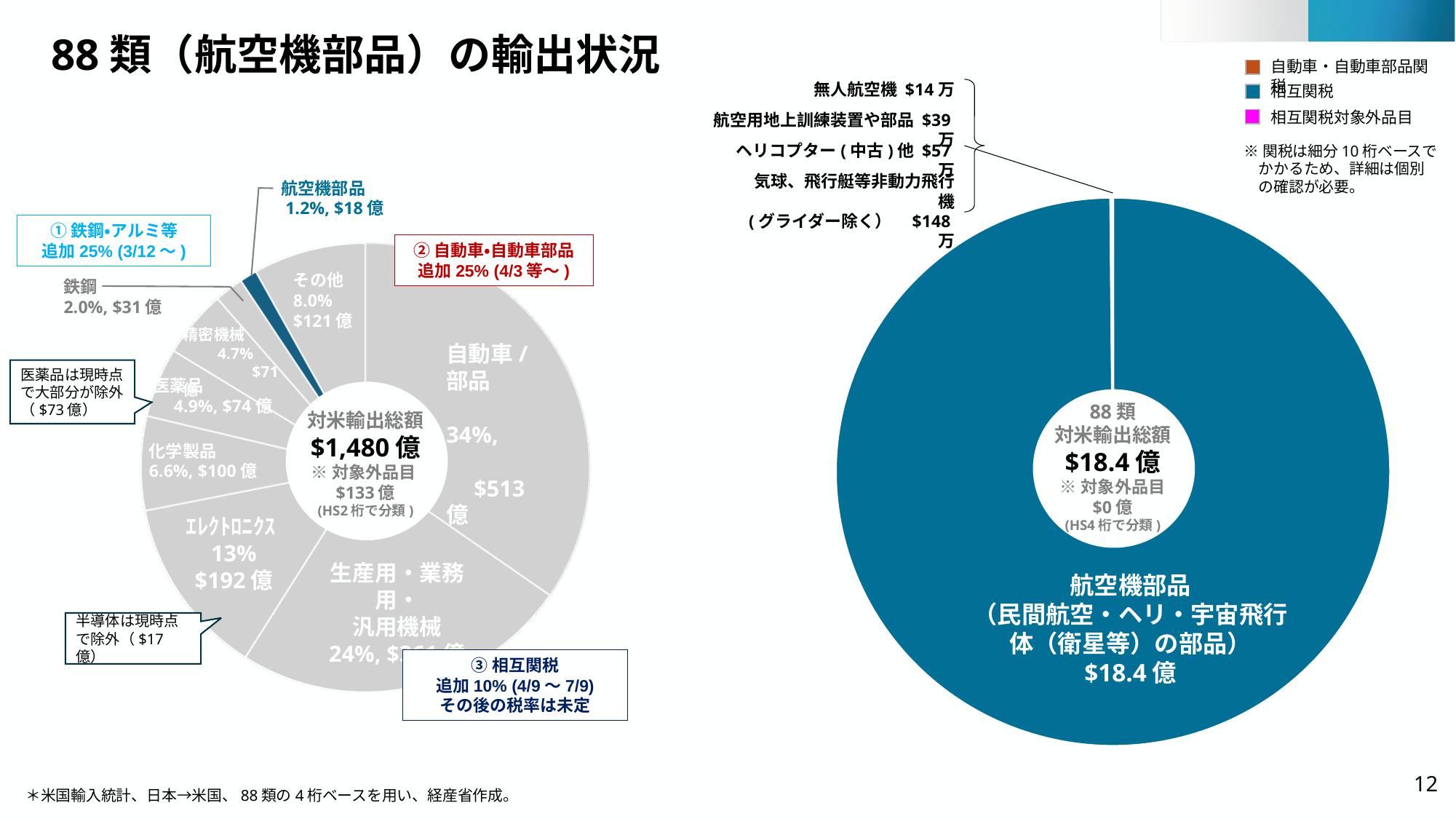
In the right donut chart, what is the 88類 対米輸出総額 shown in the centre? $18.4億 In the left donut chart, what is the value shown for 航空機部品? 1.2%, $18億 In the left donut chart, which is larger: 鉄鋼 or 化学製品? 化学製品 In the right donut chart, what value is shown for 無人航空機? $14万 In the left donut chart, what is the difference in value between 化学製品 ($100億) and 医薬品 ($74億)? $26億 In the left donut chart, what share and value are shown for エレクトロニクス? 13%, $192億 How many entries does the legend at the top right of the slide list? 3 In the right donut chart, what value is shown for ヘリコプター(中古)他? $57万 In the left donut chart, which labelled category has the smallest share? 航空機部品 In the left donut chart, which category has the largest share? 自動車/部品 In the left donut chart, what total is shown in the centre as 対米輸出総額? $1,480億 In the left donut chart, what is the value shown for 自動車/部品? 34%, $513億